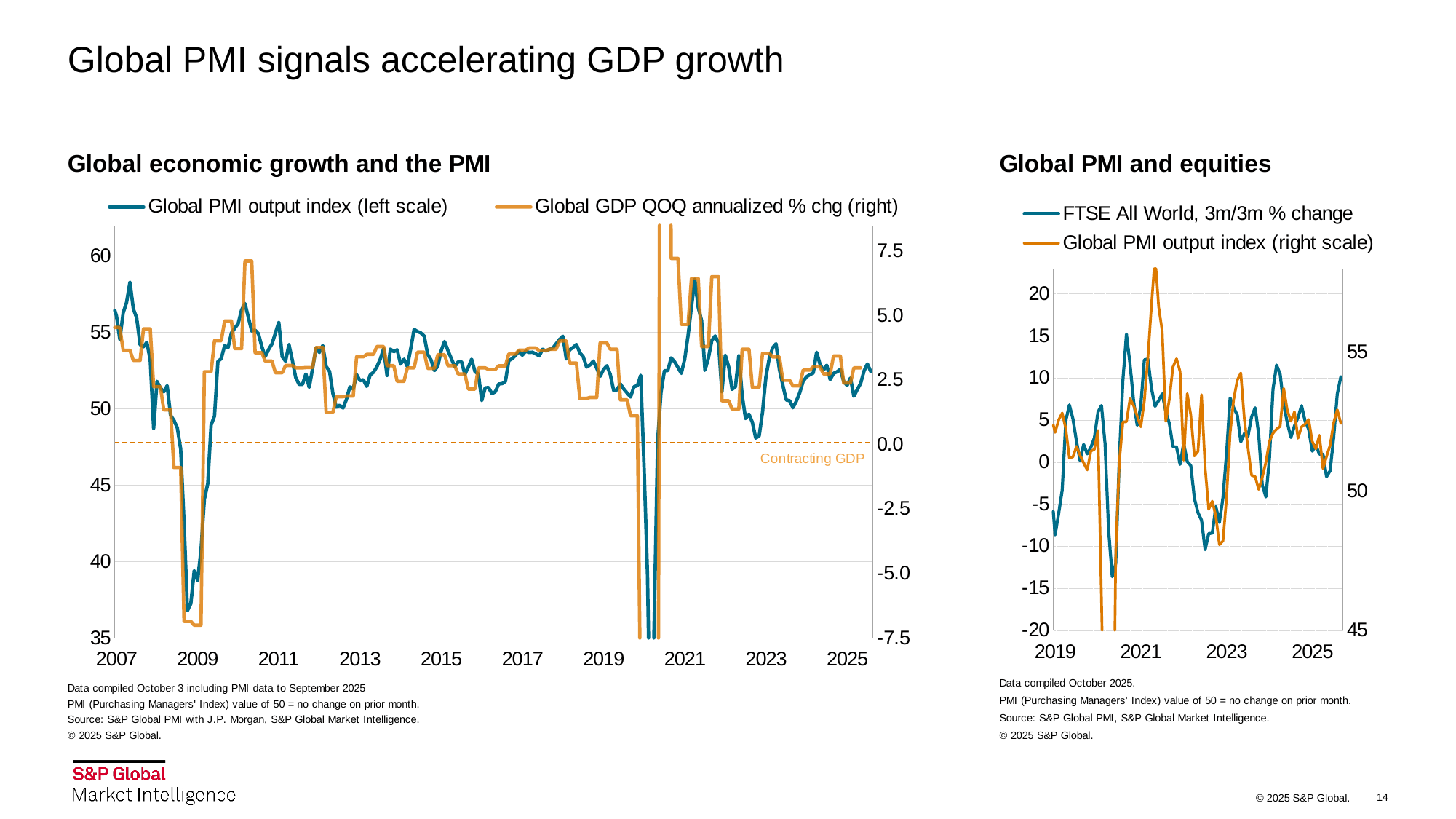
In the 'Global PMI and equities' chart, is the peak of the FTSE All World 3m/3m % change in late 2020 greater or less than 10? greater In the 'Global PMI and equities' chart, is the lowest value of the FTSE All World 3m/3m % change during 2022 greater or less than -5? less In the 'Global economic growth and the PMI' chart, does the Global PMI output index rise or fall between 2007 and 2009? fall In the 'Global economic growth and the PMI' chart, which series is plotted on the right scale? Global GDP QOQ annualized % chg What kind of chart is the 'Global PMI and equities' chart? line chart What kind of chart is the 'Global economic growth and the PMI' chart? line chart In the 'Global economic growth and the PMI' chart, is the lowest value of the Global PMI output index around 2009 greater or less than 40? less How many series does the legend of the 'Global economic growth and the PMI' chart list? 2 How many series does the legend of the 'Global PMI and equities' chart list? 2 In the 'Global PMI and equities' chart, which series is plotted on the right scale? Global PMI output index In the 'Global PMI and equities' chart, does the FTSE All World 3m/3m % change rise or fall over the course of 2025? rise